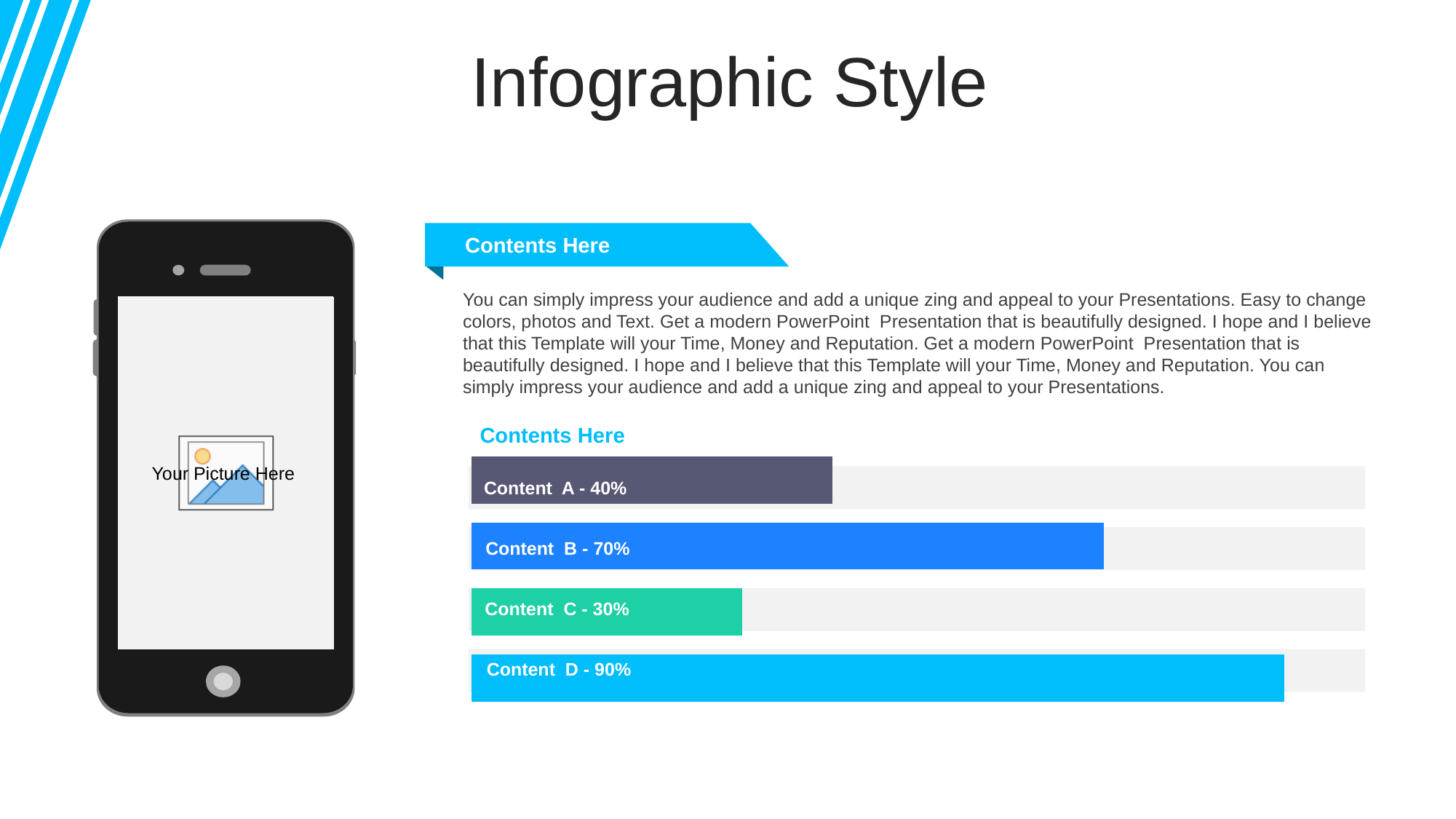
Which is larger, the value for Content A or the value for Content B? Content B How many categories are shown in the chart? 4 What colour is the bar for Content C? Green What is the value for Content C? 30% What is the value for Content B? 70% What is the difference between the values for Content D and Content A? 50% What is the value for Content D? 90% Which category has the lowest value? Content C What is the difference between the values for Content B and Content C? 40% What is the value for Content A? 40% Which category has the highest value? Content D What kind of chart is shown on the slide? Bar chart